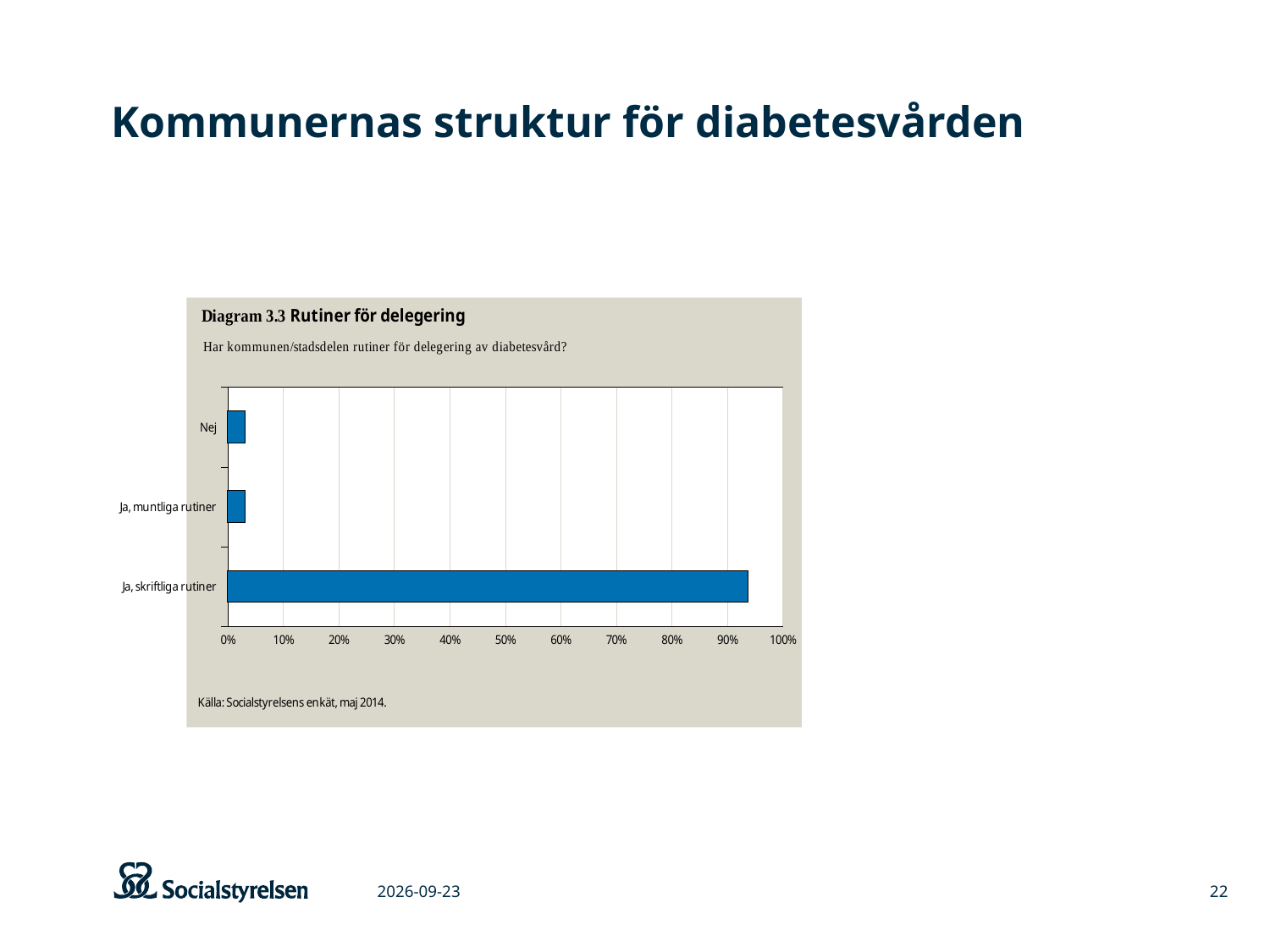
What is the highest value shown on the x axis of the chart? 100% How many categories are plotted in the chart? 3 Which category has the highest value in the chart? Ja, skriftliga rutiner What is the title of the diagram on the slide? Diagram 3.3 Rutiner för delegering Which is larger, the value for Ja, skriftliga rutiner or the value for Nej? Ja, skriftliga rutiner Is the value for Ja, skriftliga rutiner greater or less than 80%? greater What kind of chart is shown in Diagram 3.3? bar chart Which is larger, the value for Ja, muntliga rutiner or the value for Ja, skriftliga rutiner? Ja, skriftliga rutiner Is the value for Ja, muntliga rutiner greater or less than 10%? less Is the value for Nej greater or less than 10%? less